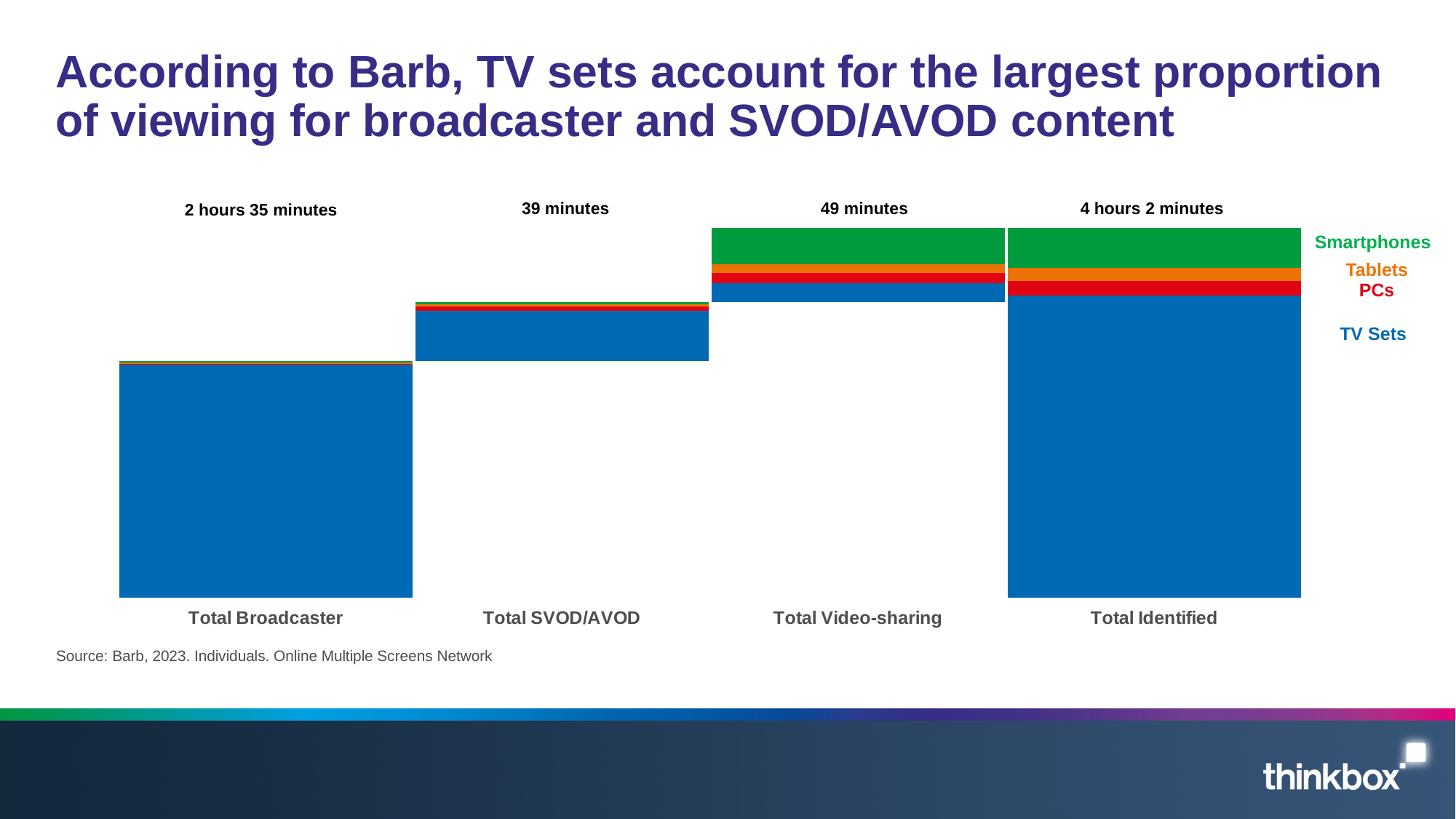
What kind of chart is shown on the slide? Stacked bar chart How many minutes longer is the Total Video-sharing total than the Total SVOD/AVOD total? 10 minutes Which has a larger total viewing time, Total Video-sharing or Total SVOD/AVOD? Total Video-sharing Which category has the highest total viewing time? Total Identified What is the total viewing time shown for Total Identified? 4 hours 2 minutes What is the total viewing time shown for Total Video-sharing? 49 minutes Which device accounts for the largest portion of the Total Video-sharing bar? Smartphones Which category has the lowest total viewing time? Total SVOD/AVOD What is the total viewing time shown for Total Broadcaster? 2 hours 35 minutes What is the total viewing time shown for Total SVOD/AVOD? 39 minutes How many device series does the legend list? 4 How many categories are shown along the x axis? 4